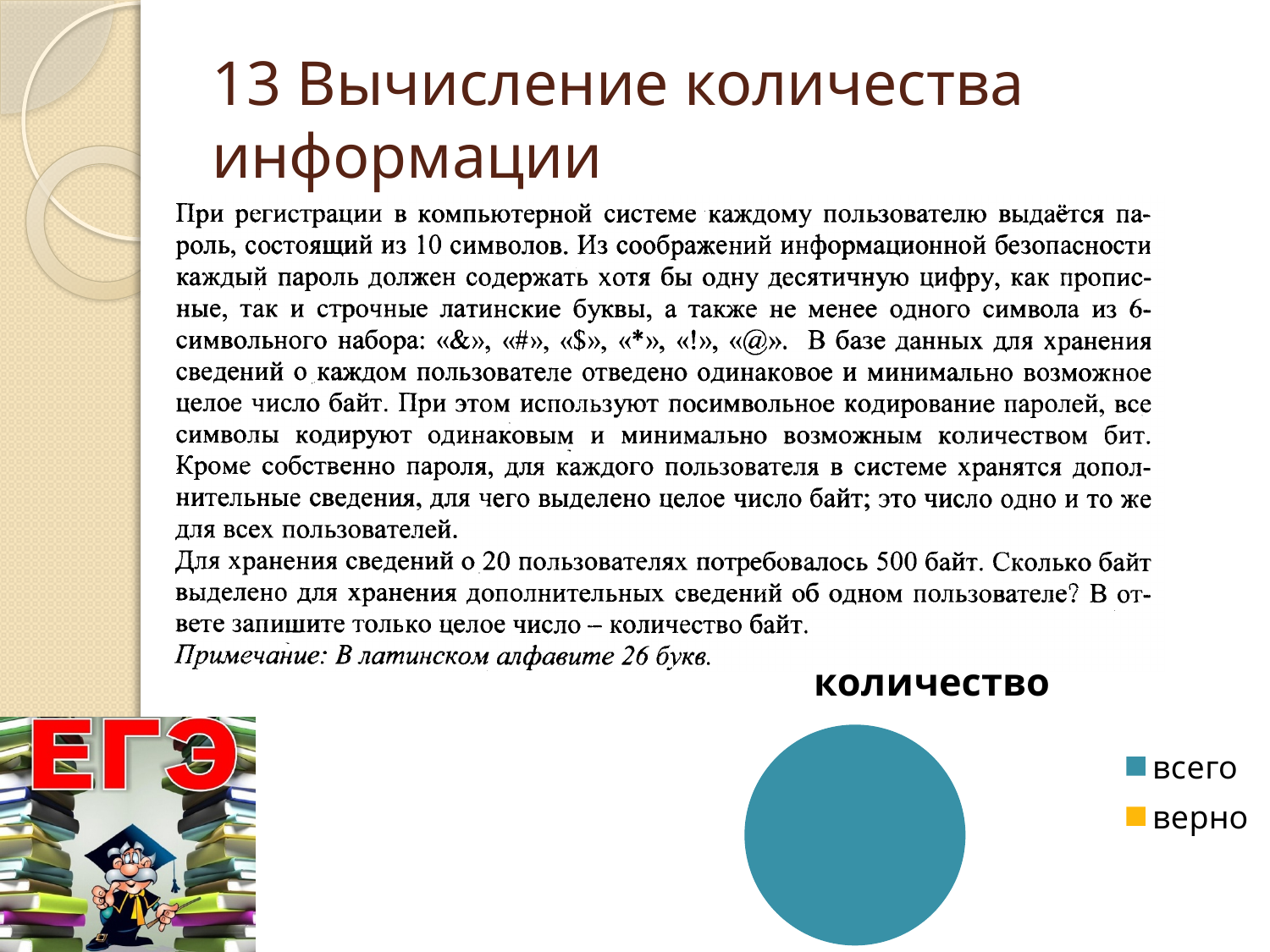
Which legend entry occupies the larger part of the pie, всего or верно? всего How many entries does the chart's legend list? 2 What colour represents всего in the chart? blue Which category has the largest slice of the pie? всего What kind of chart is shown on the slide? pie chart What is the title of the chart? количество Which category has the smallest slice of the pie? верно